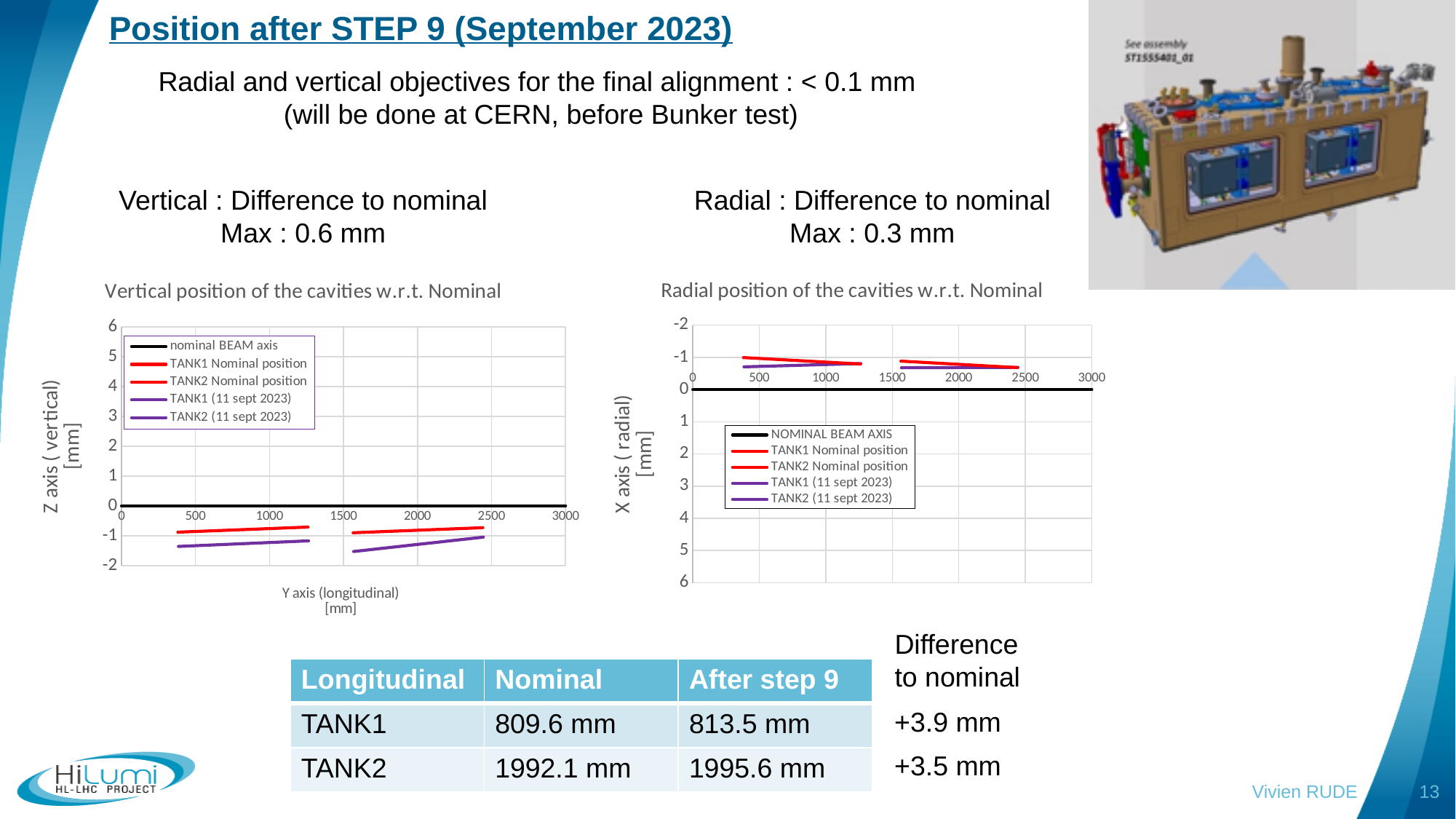
In the 'Vertical position of the cavities w.r.t. Nominal' chart, what value does the 'nominal BEAM axis' line sit at on the Z axis? 0 What is the y-axis title of the 'Radial position of the cavities w.r.t. Nominal' chart? X axis ( radial) [mm] What kind of chart is the 'Radial position of the cavities w.r.t. Nominal' chart? line chart What is the x-axis title of the 'Vertical position of the cavities w.r.t. Nominal' chart? Y axis (longitudinal) [mm] How many series does the legend of the 'Vertical position of the cavities w.r.t. Nominal' chart list? 5 How many series does the legend of the 'Radial position of the cavities w.r.t. Nominal' chart list? 5 What kind of chart is the 'Vertical position of the cavities w.r.t. Nominal' chart? line chart In the 'Vertical position of the cavities w.r.t. Nominal' chart, does the 'TANK2 (11 sept 2023)' line rise or fall along the Y axis (longitudinal)? rise In the 'Vertical position of the cavities w.r.t. Nominal' chart, which line has the higher Z axis values: 'TANK1 Nominal position' or 'TANK1 (11 sept 2023)'? TANK1 Nominal position In the 'Radial position of the cavities w.r.t. Nominal' chart, what value does the 'NOMINAL BEAM AXIS' line sit at on the X axis? 0 In the 'Vertical position of the cavities w.r.t. Nominal' chart, is the value of the 'TANK1 (11 sept 2023)' line greater or less than 0? less In the 'Vertical position of the cavities w.r.t. Nominal' chart, is the value of the 'TANK2 Nominal position' line greater or less than -2? greater